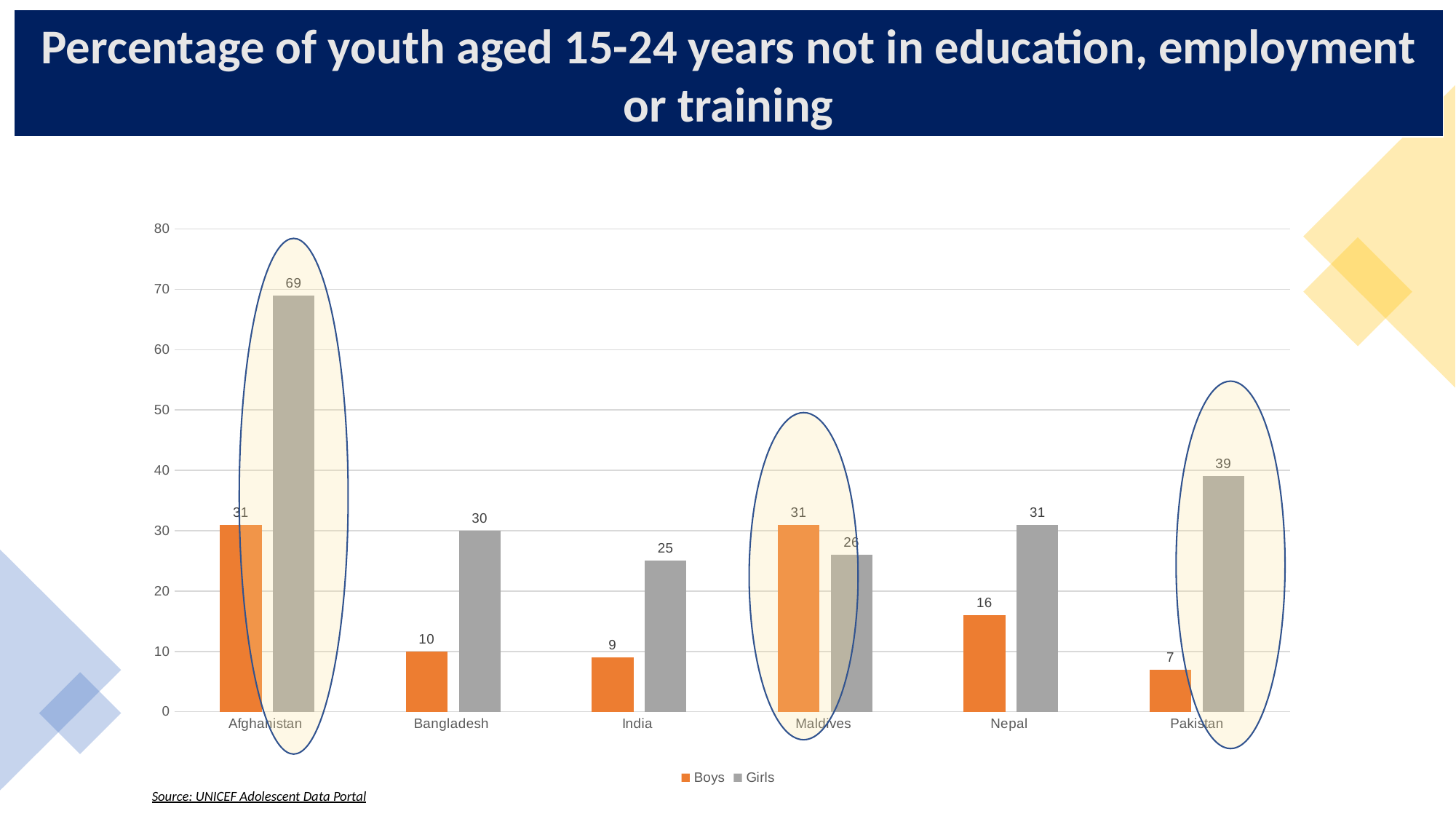
What is the value for Girls in Afghanistan? 69 What source is cited for the chart? UNICEF Adolescent Data Portal How many countries are shown on the x axis? 6 What is the value for Boys in Nepal? 16 Which country has the highest value for Girls? Afghanistan Is the value for Girls in Pakistan greater or less than 30? greater How many series does the legend list? 2 What is the value for Boys in Pakistan? 7 What kind of chart is shown on the slide? Bar chart In Maldives, which is larger, the value for Boys or the value for Girls? Boys Which country has the lowest value for Boys? Pakistan What is the difference between the Girls and Boys values in Afghanistan? 38